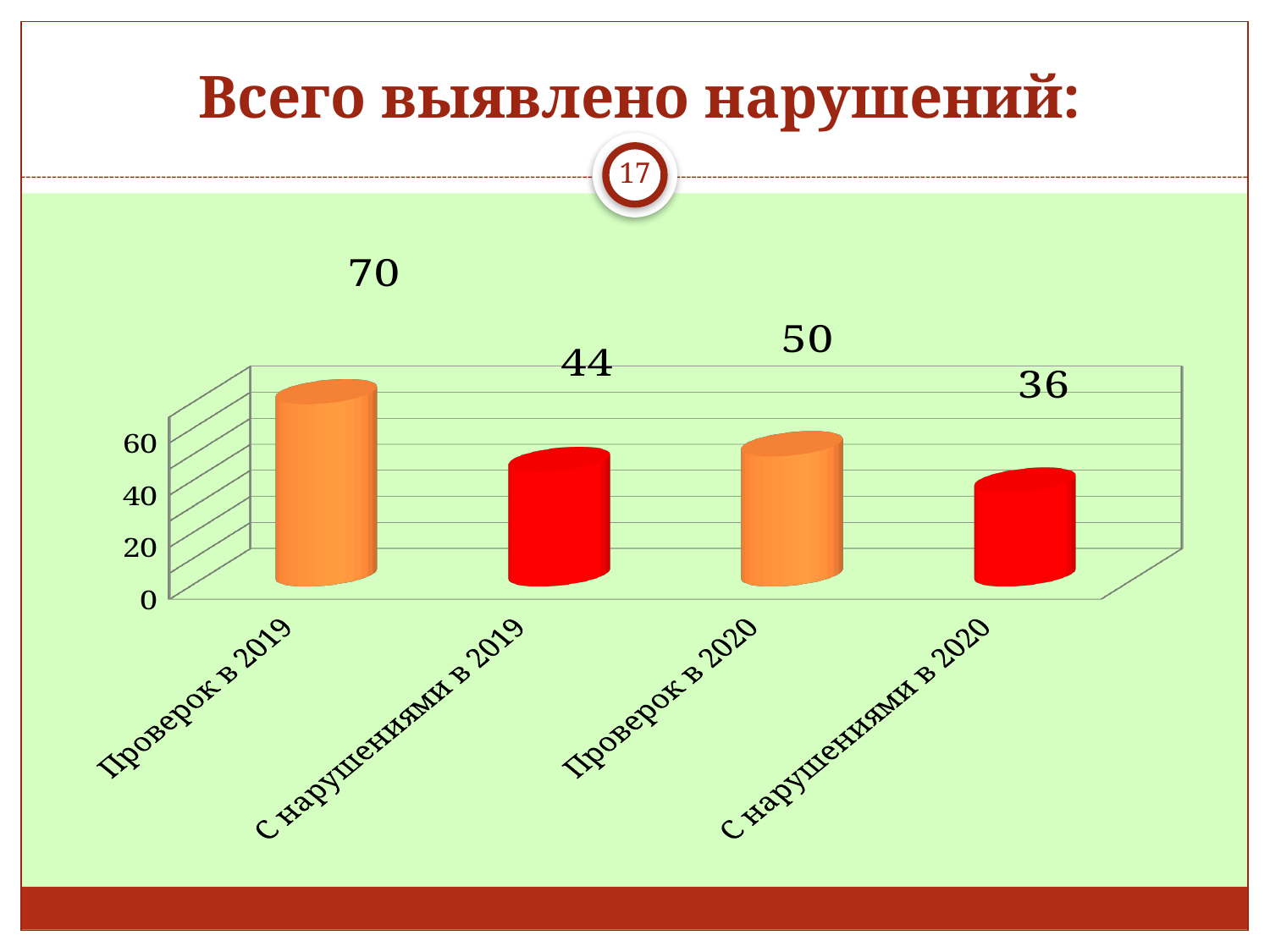
How many categories are shown in the chart? 4 Which is larger, "С нарушениями в 2019" or "Проверок в 2020"? Проверок в 2020 Which category has the lowest value? С нарушениями в 2020 What is the difference between "Проверок в 2019" and "Проверок в 2020"? 20 What is the value for "С нарушениями в 2020"? 36 Which category has the highest value? Проверок в 2019 What is the value for "С нарушениями в 2019"? 44 What is the value for "Проверок в 2019"? 70 What is the title of the slide? Всего выявлено нарушений: What is the difference between "С нарушениями в 2019" and "С нарушениями в 2020"? 8 What kind of chart is shown on the slide? Bar chart What is the value for "Проверок в 2020"? 50